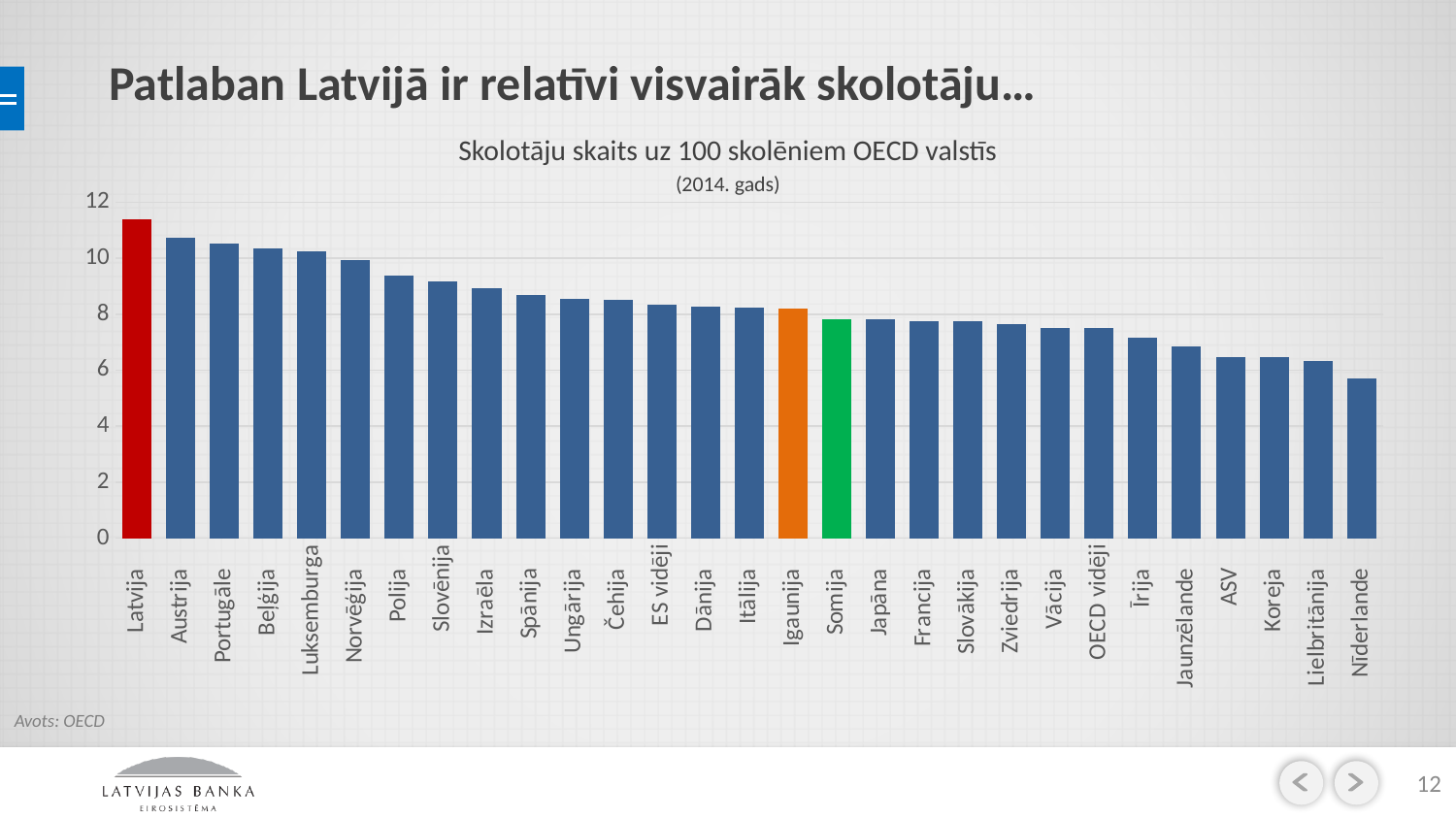
How many countries or groups are shown on the x axis? 29 What type of chart is shown on the slide? bar chart Which country has the lowest number of teachers per 100 pupils? Nīderlande Which has a larger value, Austrija or Koreja? Austrija What is the title of the chart? Skolotāju skaits uz 100 skolēniem OECD valstīs (2014. gads) Which country has the highest number of teachers per 100 pupils? Latvija Is the value for Īrija greater or less than 8? less Is the value for Polija greater or less than 8? greater Is the value for Latvija greater or less than 10? greater Do the values rise or fall from left to right along the x axis? fall Which has a larger value, Igaunija or Jaunzēlande? Igaunija